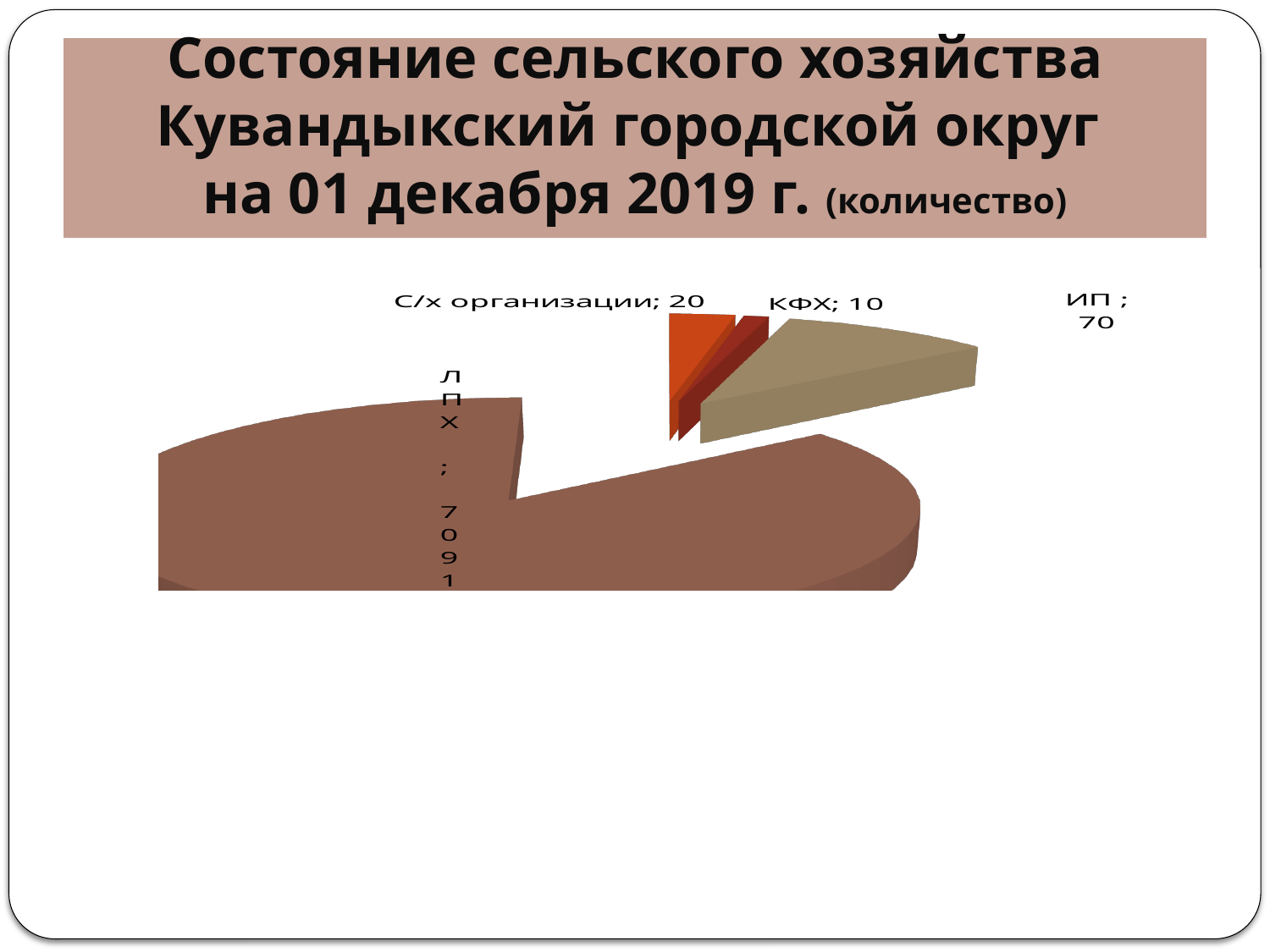
Which is larger, the value for ИП or the value for КФХ? ИП Which category has the largest value? ЛПХ What is the value for С/х организации? 20 What is the total of all the values shown in the pie chart? 7191 What is the difference between the values for С/х организации and КФХ? 10 How many categories are shown in the pie chart? 4 What kind of chart is shown on the slide? pie chart Which category has the smallest value? КФХ What is the value for ЛПХ? 7091 What is the difference between the values for ИП and С/х организации? 50 What is the value for ИП? 70 What is the value for КФХ? 10